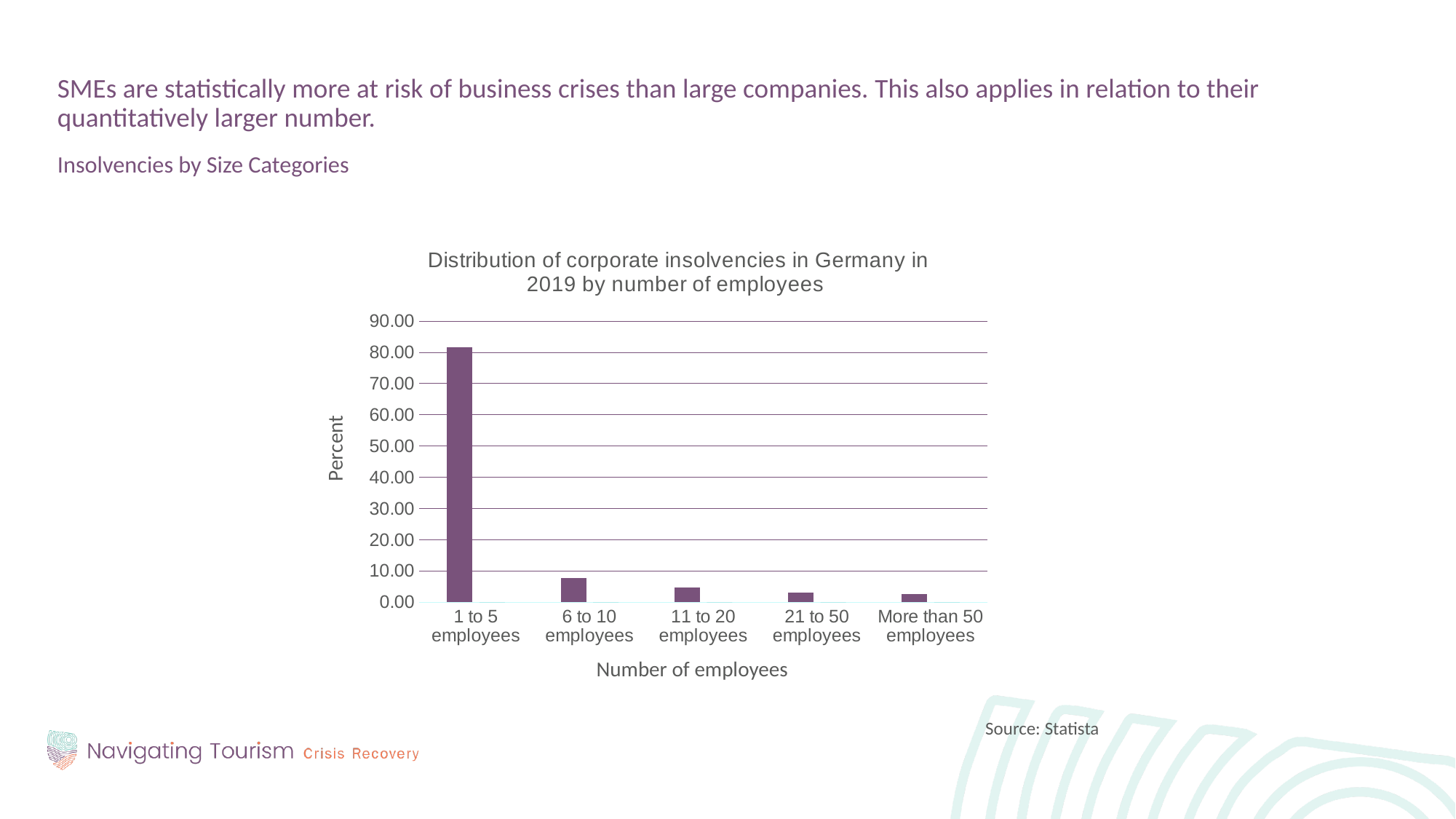
Which is larger, the value for 6 to 10 employees or the value for 11 to 20 employees? 6 to 10 employees Is the value for 6 to 10 employees greater or less than 10? less Is the value for 11 to 20 employees greater or less than 10? less Do the values rise or fall as the number of employees increases along the x axis? fall Is the value for 1 to 5 employees greater or less than 90? less What is the title of the chart? Distribution of corporate insolvencies in Germany in 2019 by number of employees What kind of chart is shown on the slide? bar chart Which employee-size category has the highest share of corporate insolvencies? 1 to 5 employees What is the label of the vertical axis? Percent Which is larger, the value for 1 to 5 employees or the value for More than 50 employees? 1 to 5 employees How many employee-size categories are plotted on the x axis? 5